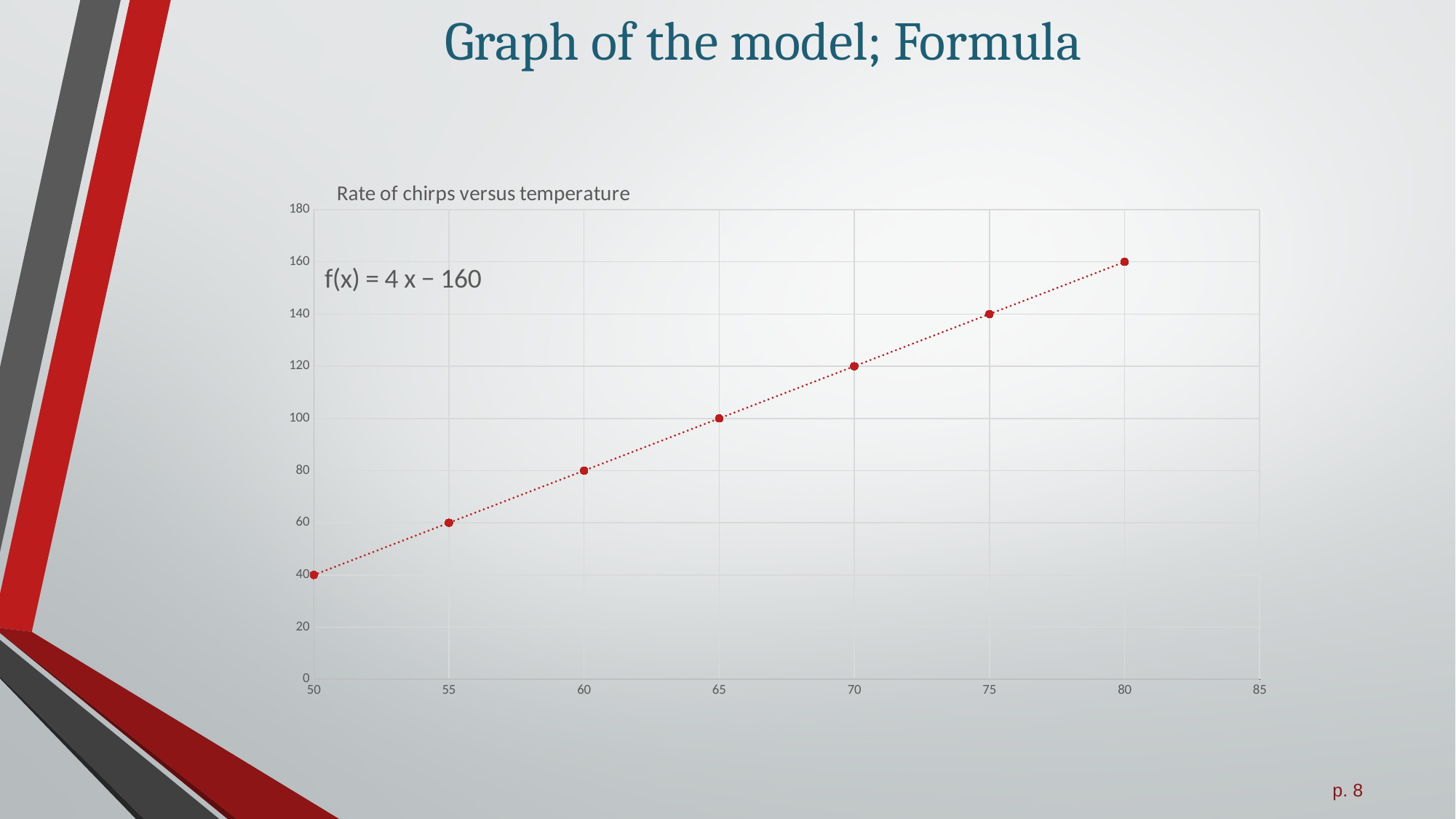
What formula is displayed on the chart? f(x) = 4 x − 160 At which x value is the plotted value lowest? 50 Do the plotted values rise or fall as x increases? rise What kind of chart is shown on the slide? scatter chart What is the difference between the values plotted at x = 80 and x = 50? 120 How many data points are plotted on the chart? 7 What is the value plotted at x = 80? 160 At which x value is the plotted value highest? 80 Which has the larger plotted value, x = 60 or x = 70? 70 What is the value plotted at x = 65? 100 What is the value plotted at x = 50? 40 What is the title of the chart? Rate of chirps versus temperature